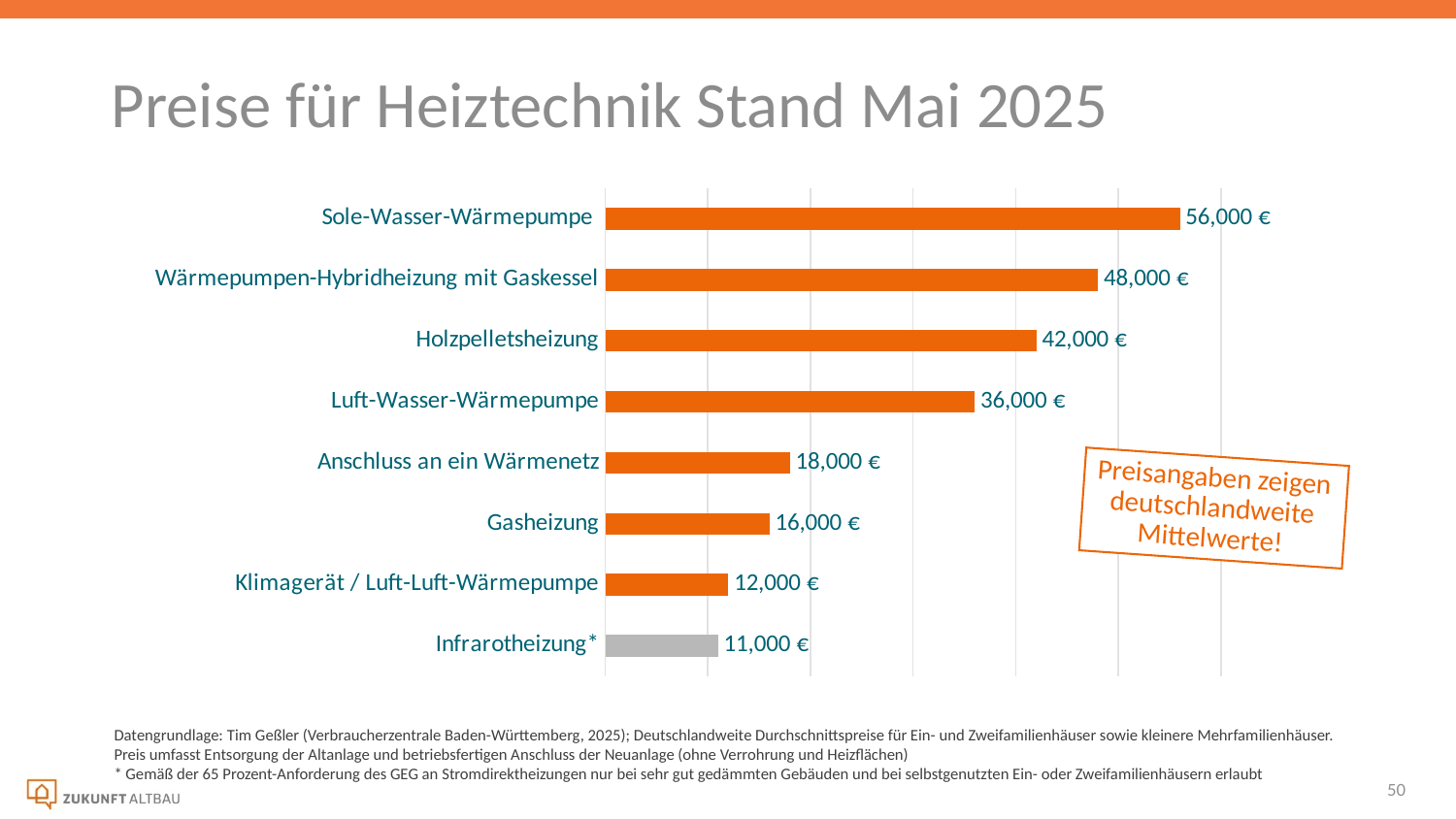
What is the price shown for Gasheizung? 16,000 € Which is more expensive, Klimagerät / Luft-Luft-Wärmepumpe or Anschluss an ein Wärmenetz? Anschluss an ein Wärmenetz What is the price shown for Anschluss an ein Wärmenetz? 18,000 € How many heating technologies are shown on the chart? 8 What is the price shown for Sole-Wasser-Wärmepumpe? 56,000 € What is the price shown for Holzpelletsheizung? 42,000 € Which bar on the chart is coloured grey instead of orange? Infrarotheizung* What kind of chart is shown on the slide? Bar chart Which heating technology has the lowest price on the chart? Infrarotheizung* What is the difference in price between Wärmepumpen-Hybridheizung mit Gaskessel and Gasheizung? 32,000 € Which heating technology has the highest price on the chart? Sole-Wasser-Wärmepumpe What is the difference in price between Sole-Wasser-Wärmepumpe and Luft-Wasser-Wärmepumpe? 20,000 €